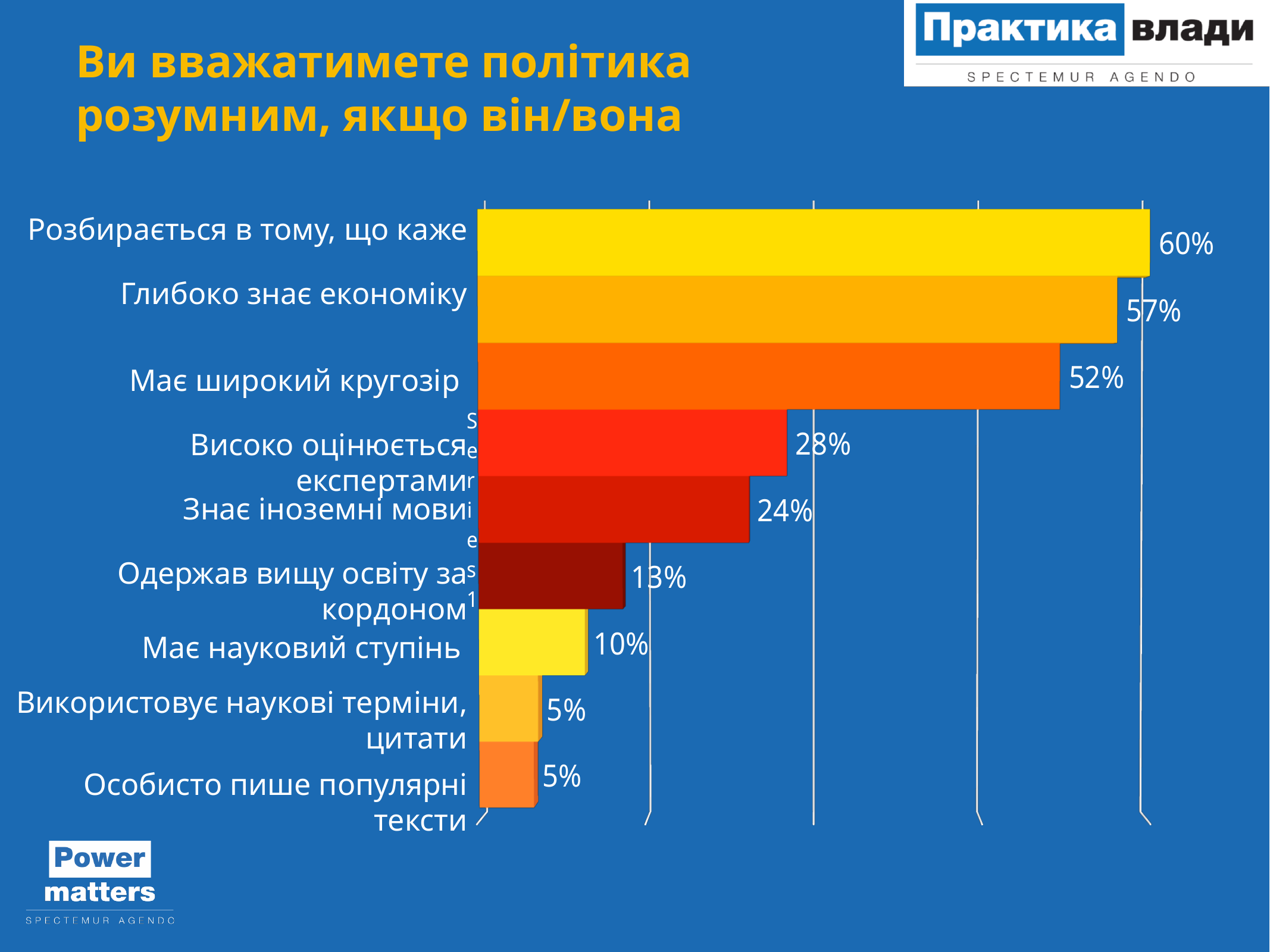
What kind of chart is shown on the slide? Bar chart Which category has the highest value? Розбирається в тому, що каже What is the value for "Має широкий кругозір"? 52% How many categories are shown in the chart? 9 What is the difference between the values for "Має широкий кругозір" and "Високо оцінюється експертами"? 24% What is the value for "Глибоко знає економіку"? 57% What is the value for "Знає іноземні мови"? 24% What is the value for "Використовує наукові терміни, цитати"? 5% What percentage of respondents would consider a politician smart if he/she "Розбирається в тому, що каже"? 60% What is the value for "Має науковий ступінь"? 10% Which is larger: the value for "Високо оцінюється експертами" or for "Знає іноземні мови"? Високо оцінюється експертами What is the difference between the values for "Розбирається в тому, що каже" and "Глибоко знає економіку"? 3%